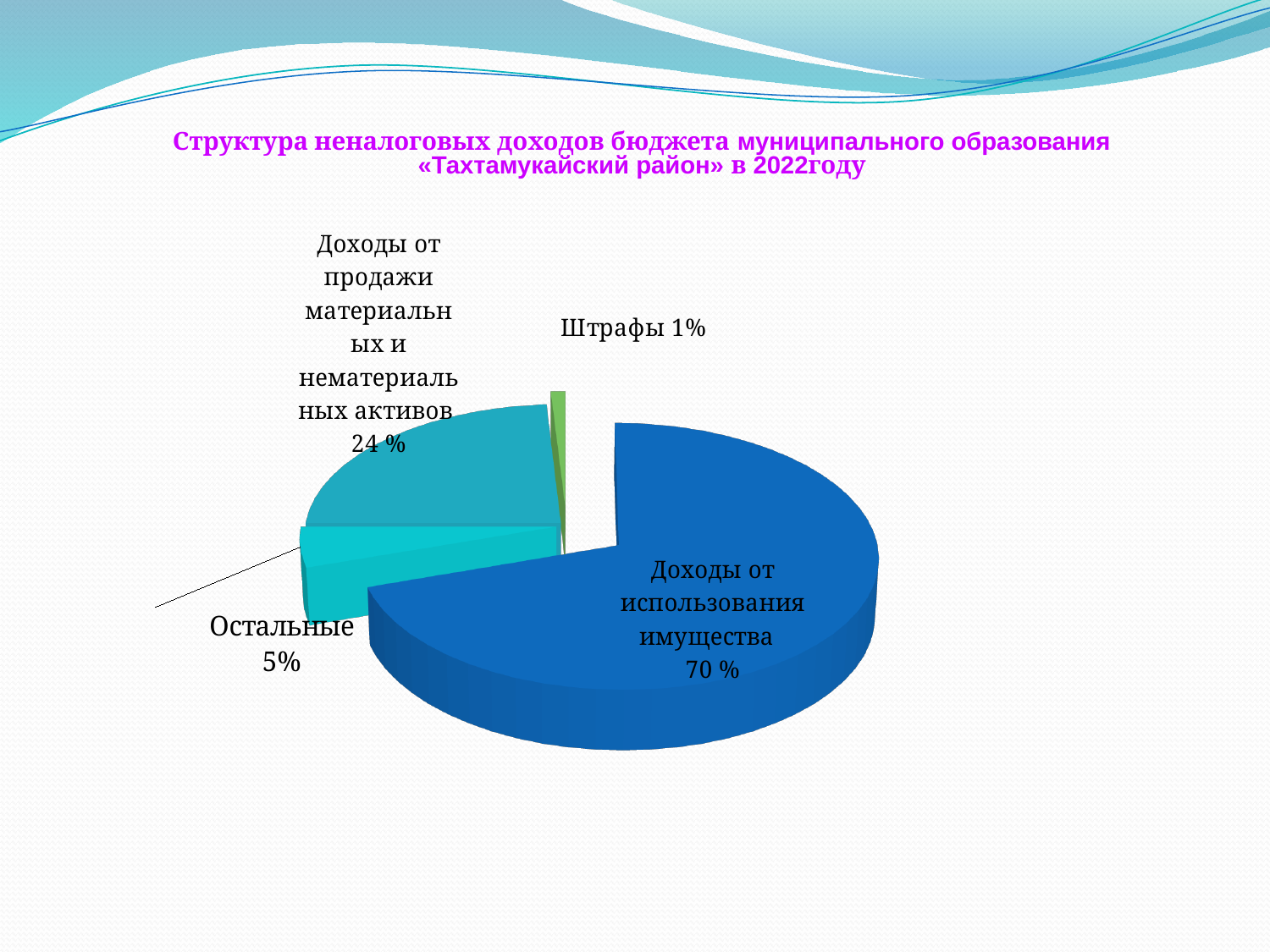
Which is larger: the share for «Остальные» or the share for «Штрафы»? Остальные What year does the chart title refer to? 2022 By how many percentage points does «Остальные» exceed «Штрафы»? 4 What share is shown for «Остальные»? 5% What share is shown for «Штрафы»? 1% What share is shown for «Доходы от продажи материальных и нематериальных активов»? 24 % Which category has the largest share of the pie? Доходы от использования имущества Which category has the smallest share of the pie? Штрафы How many slices does the pie chart have? 4 By how many percentage points does «Доходы от использования имущества» exceed «Доходы от продажи материальных и нематериальных активов»? 46 What share of non-tax revenues comes from «Доходы от использования имущества»? 70 % What type of chart is shown on the slide? pie chart